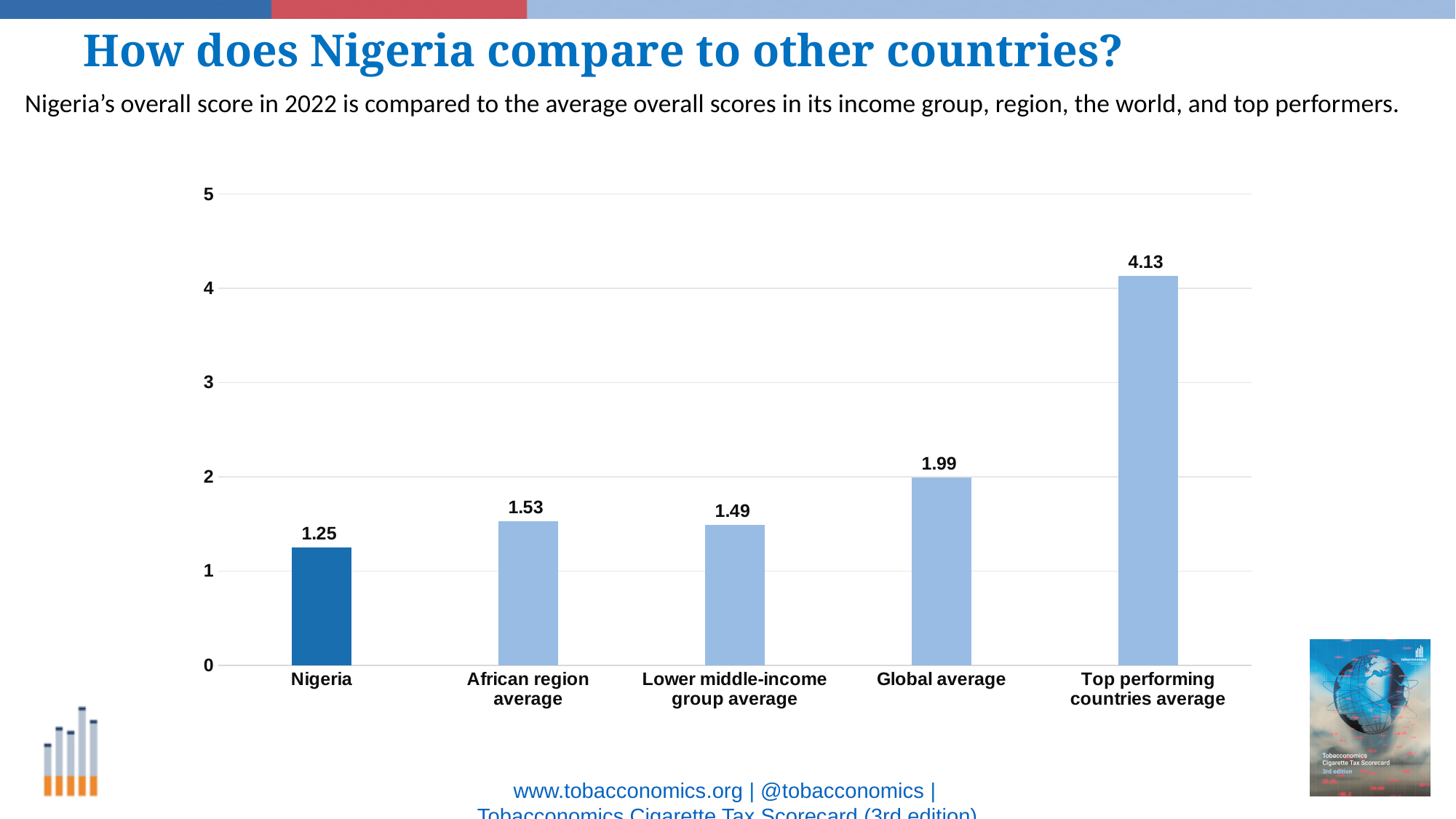
How many categories are shown on the chart? 5 What kind of chart is shown on the slide? Bar chart What is the value for the Lower middle-income group average? 1.49 What is the difference between the Top performing countries average and Nigeria? 2.88 Which category has the highest value? Top performing countries average What is the value for the Top performing countries average? 4.13 Which is larger, the Global average or the African region average? Global average What is the value for Nigeria? 1.25 Which category has the lowest value? Nigeria What is the difference between the African region average and Nigeria? 0.28 What is the value for the Global average? 1.99 Is the value for the Top performing countries average greater or less than 4? greater